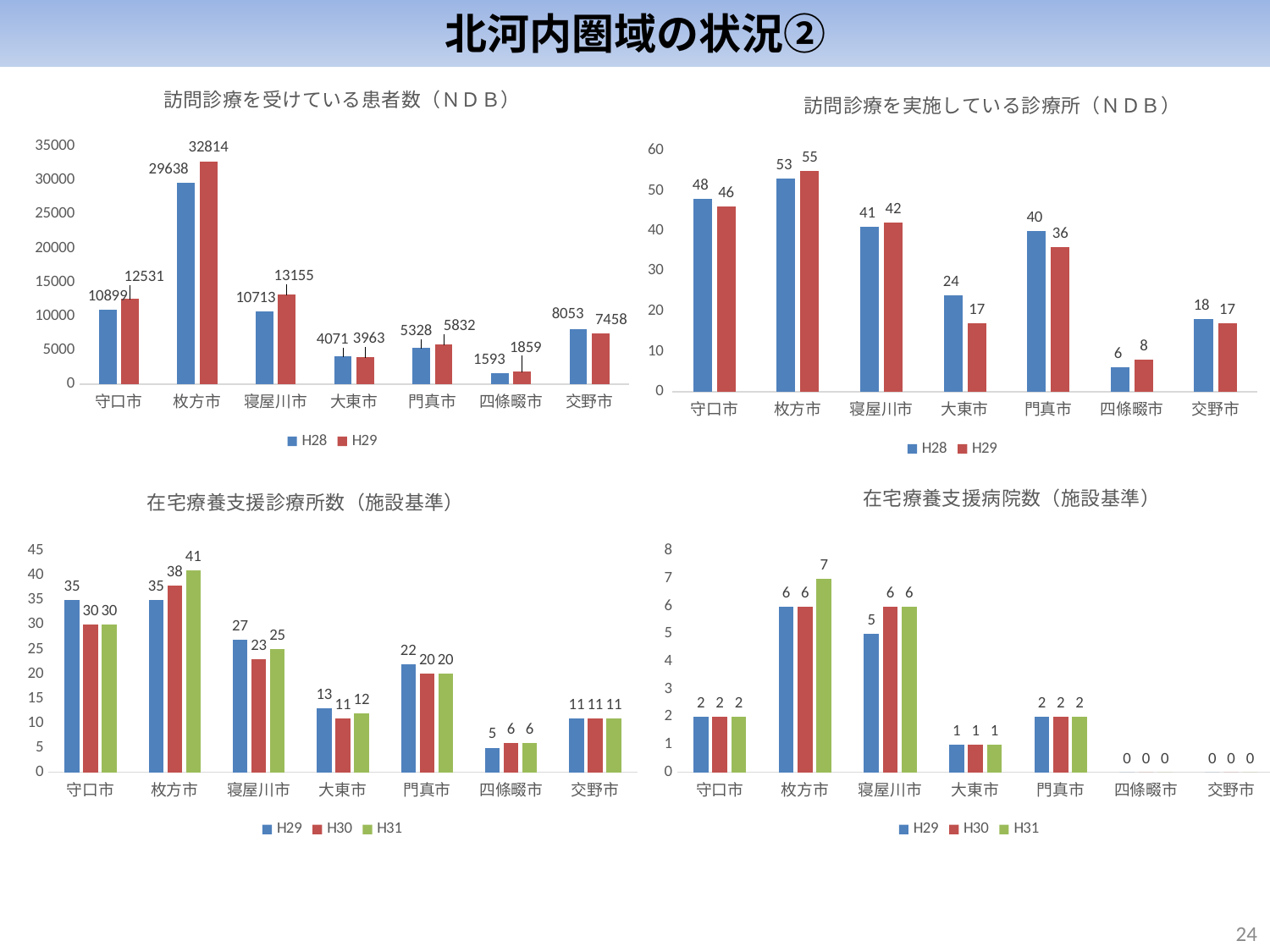
In the chart titled 訪問診療を実施している診療所（ＮＤＢ）, what is the H28 value for 大東市? 24 In the chart titled 在宅療養支援診療所数（施設基準）, how many series does the legend list? 3 In the chart titled 在宅療養支援診療所数（施設基準）, do the values for 枚方市 rise or fall from H29 to H31? rise In the chart titled 在宅療養支援病院数（施設基準）, what is the H31 value for 寝屋川市? 6 In the chart titled 在宅療養支援診療所数（施設基準）, what is the H31 value for 枚方市? 41 In the chart titled 訪問診療を受けている患者数（ＮＤＢ）, what is the H29 value for 枚方市? 32814 In the chart titled 訪問診療を実施している診療所（ＮＤＢ）, which city has the highest H29 value? 枚方市 What type of chart is the chart titled 在宅療養支援病院数（施設基準）? bar chart In the chart titled 在宅療養支援病院数（施設基準）, how many cities are shown on the x axis? 7 In the chart titled 訪問診療を実施している診療所（ＮＤＢ）, is the H28 value for 守口市 or the H29 value for 守口市 larger? H28 In the chart titled 訪問診療を受けている患者数（ＮＤＢ）, what is the difference between the H29 and H28 values for 寝屋川市? 2442 In the chart titled 訪問診療を受けている患者数（ＮＤＢ）, which city has the lowest H28 value? 四條畷市